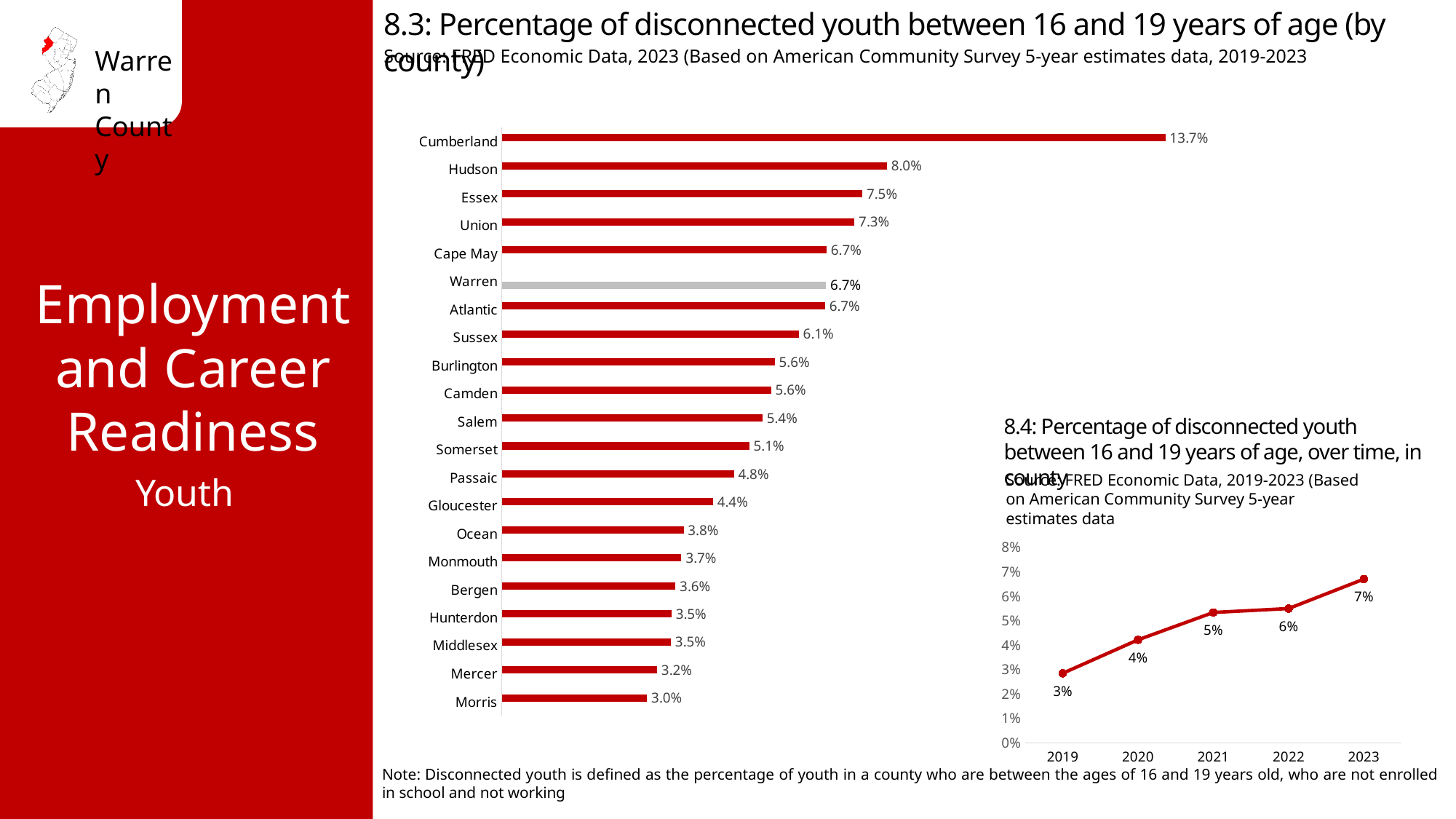
In the 8.3 bar chart (by county), what is the value for Cumberland? 13.7% In the 8.3 bar chart (by county), which county has the lowest percentage of disconnected youth? Morris In the 8.4 line chart (over time), what is the value for 2019? 3% In the 8.4 line chart (over time), what is the value for 2023? 7% In the 8.3 bar chart (by county), how many counties are shown? 21 In the 8.3 bar chart (by county), which county has the highest percentage of disconnected youth? Cumberland In the 8.3 bar chart (by county), what is the difference between Cumberland and Hudson? 5.7% In the 8.4 line chart (over time), how many years are plotted? 5 In the 8.4 line chart (over time), do the values rise or fall from 2019 to 2023? Rise What kind of chart is the 8.3 chart (by county)? Bar chart In the 8.3 bar chart (by county), what is the value for Warren? 6.7% In the 8.3 bar chart (by county), which is larger, the value for Essex or the value for Union? Essex